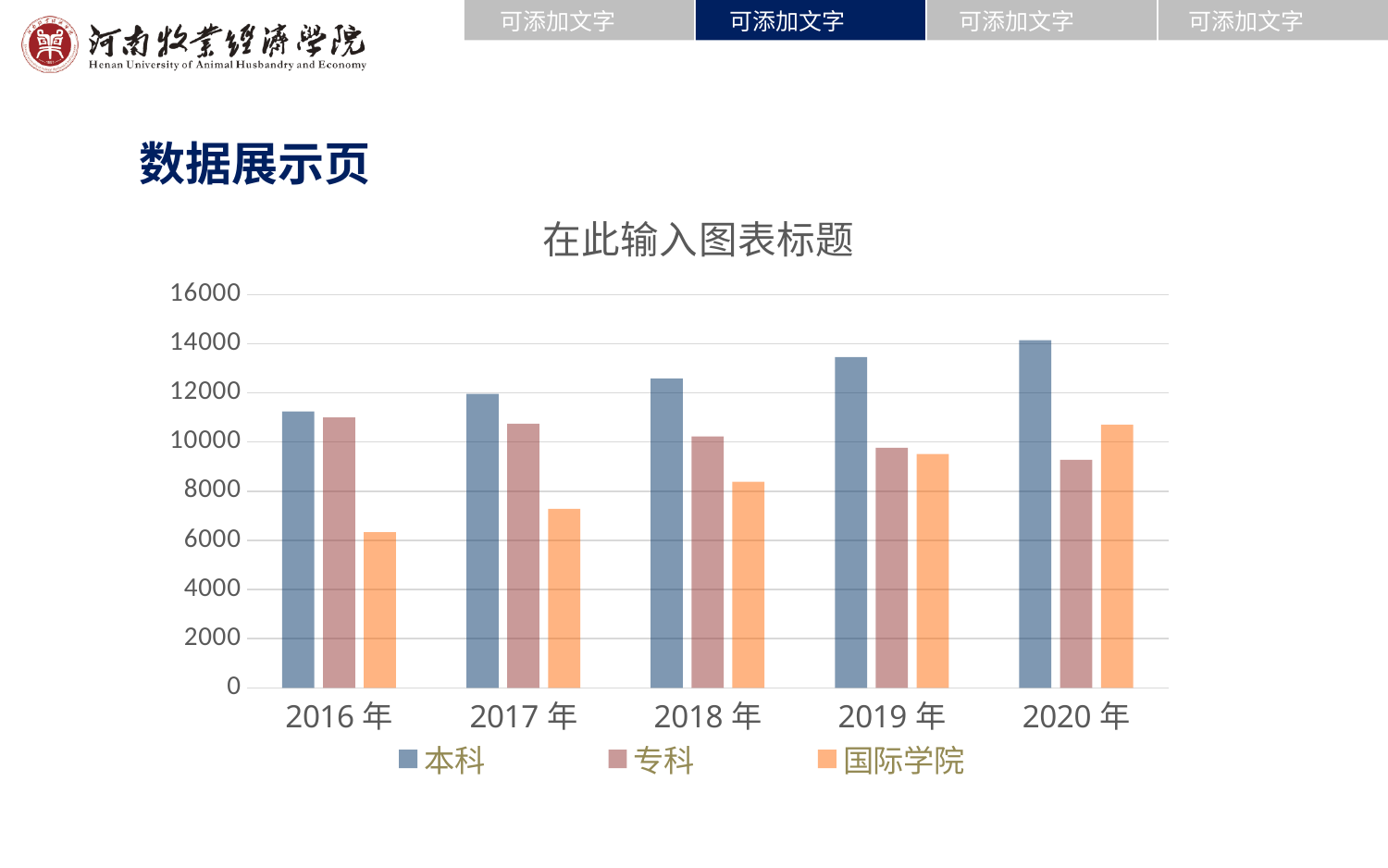
In which year is the 专科 value lowest? 2020 年 Is the 国际学院 value for 2016 年 greater or less than 8000? less How many series does the legend list? 3 What is the title of the chart? 在此输入图表标题 Which series is shown in orange in the legend? 国际学院 In 2020 年, which is larger, 专科 or 国际学院? 国际学院 What kind of chart is shown on the slide? bar chart In which year is the 本科 value highest? 2020 年 Do the 专科 values rise or fall from 2016 年 to 2020 年? fall How many year categories are shown on the x axis? 5 Is the 本科 value for 2020 年 greater or less than 12000? greater In which year is the 国际学院 value lowest? 2016 年